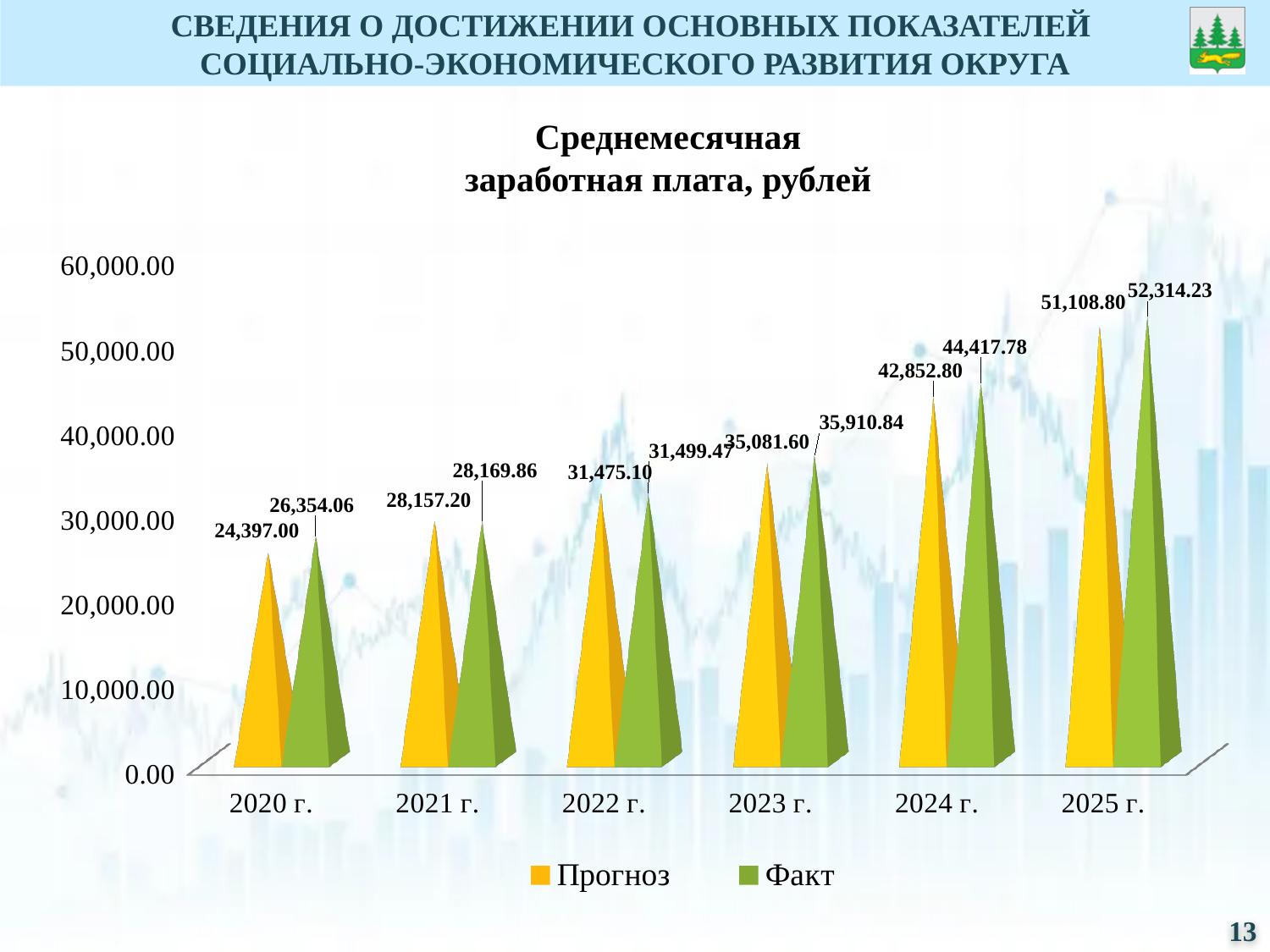
What is the difference between the Факт and Прогноз values for 2020 г.? 1,957.06 Which year has the lowest Прогноз value? 2020 г. What is the Прогноз value for 2020 г.? 24,397.00 What is the Факт value for 2025 г.? 52,314.23 Which is larger for 2024 г., the Прогноз value or the Факт value? Факт How many years are shown on the x axis? 6 Is the Факт value for 2022 г. greater or less than 30,000.00? greater What is the Факт value for 2023 г.? 35,910.84 How many series does the legend list? 2 What is the Прогноз value for 2024 г.? 42,852.80 Which year has the highest Факт value? 2025 г. Do the Прогноз values rise or fall from 2020 г. to 2025 г.? rise